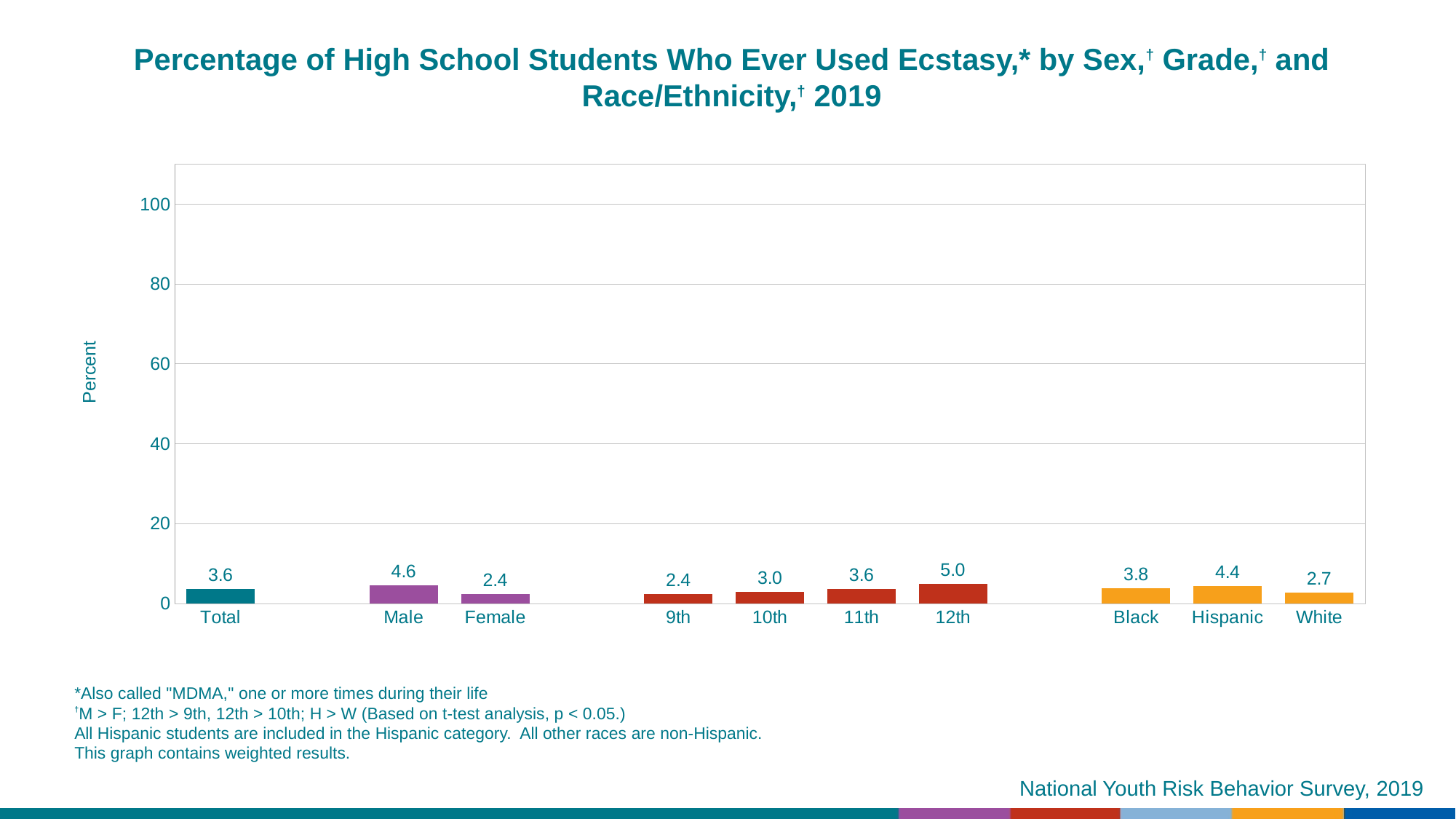
Which grade has the lowest value? 9th What kind of chart is this? bar chart How many categories are shown on the x axis? 10 Which is larger, the value for Black or the value for White? Black What is the value for Total? 3.6 What is the value for 12th grade? 5.0 What is the difference between the Hispanic and White values? 1.7 Which category has the highest value? 12th Is the value for 12th grade greater or less than 20? less What is the difference between the Male and Female values? 2.2 What is the value for Hispanic students? 4.4 What is the value for Male? 4.6